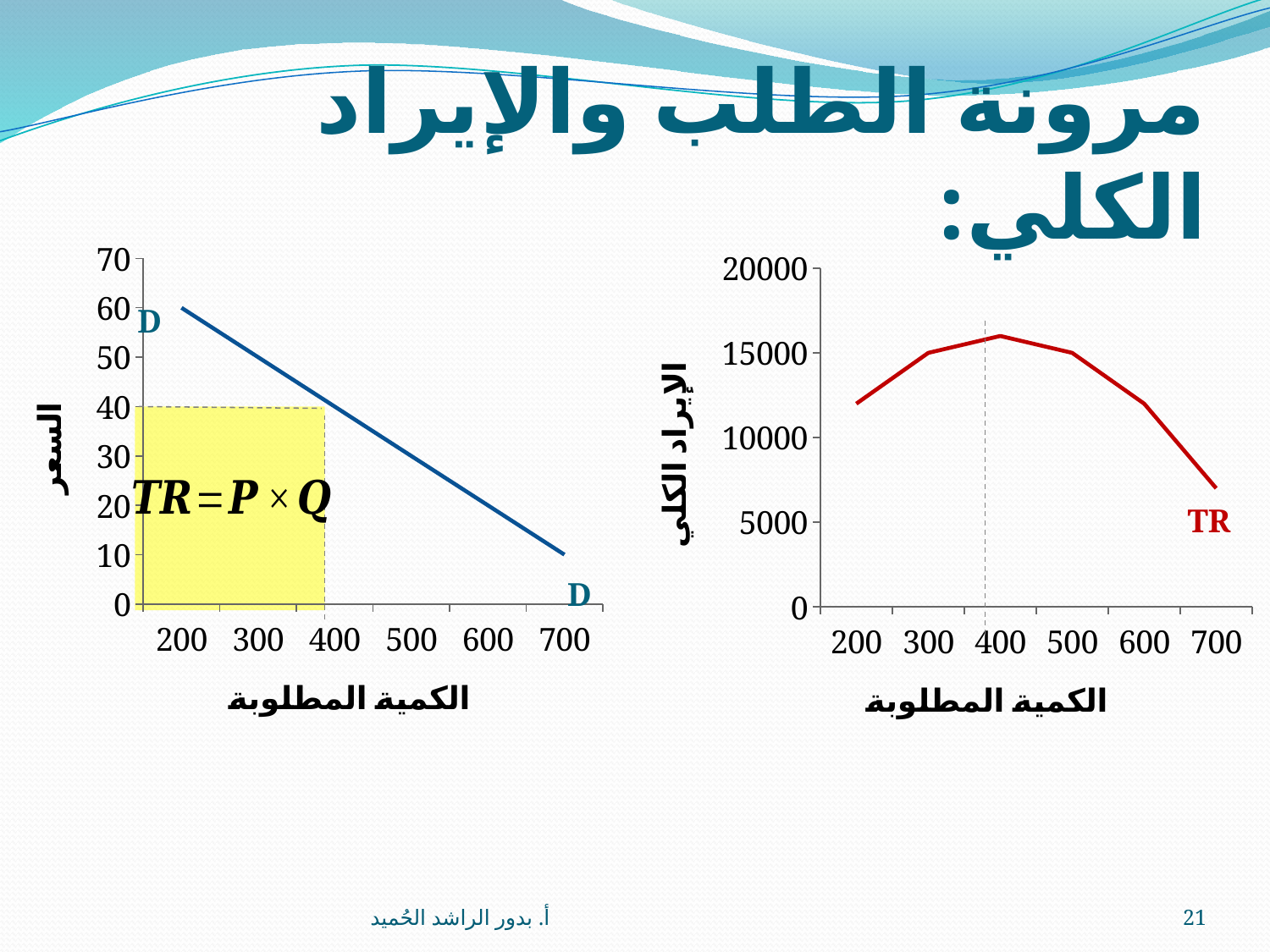
On the right chart (TR), at which quantity is total revenue highest? 400 On the right chart (TR), is the total revenue at quantity 700 greater or less than 10000? less What kind of chart is the left chart (the demand curve D)? line chart On the left chart (demand curve D), what price does the dashed line of the shaded rectangle mark at quantity 400? 40 On the right chart (TR), is the total revenue at quantity 400 greater or less than 15000? greater On the right chart (TR), which is larger: total revenue at quantity 300 or at quantity 700? 300 On the right chart (TR), at which quantity is total revenue lowest? 700 On the left chart (demand curve D), what is the price when the quantity demanded is 200? 60 On the left chart (demand curve D), what is the price when the quantity demanded is 700? 10 On the right chart, what label is written in red next to the curve? TR On the left chart (demand curve D), does the price rise or fall as the quantity demanded increases? fall On the left chart (demand curve D), what is the difference between the price at quantity 200 and the price at quantity 700? 50